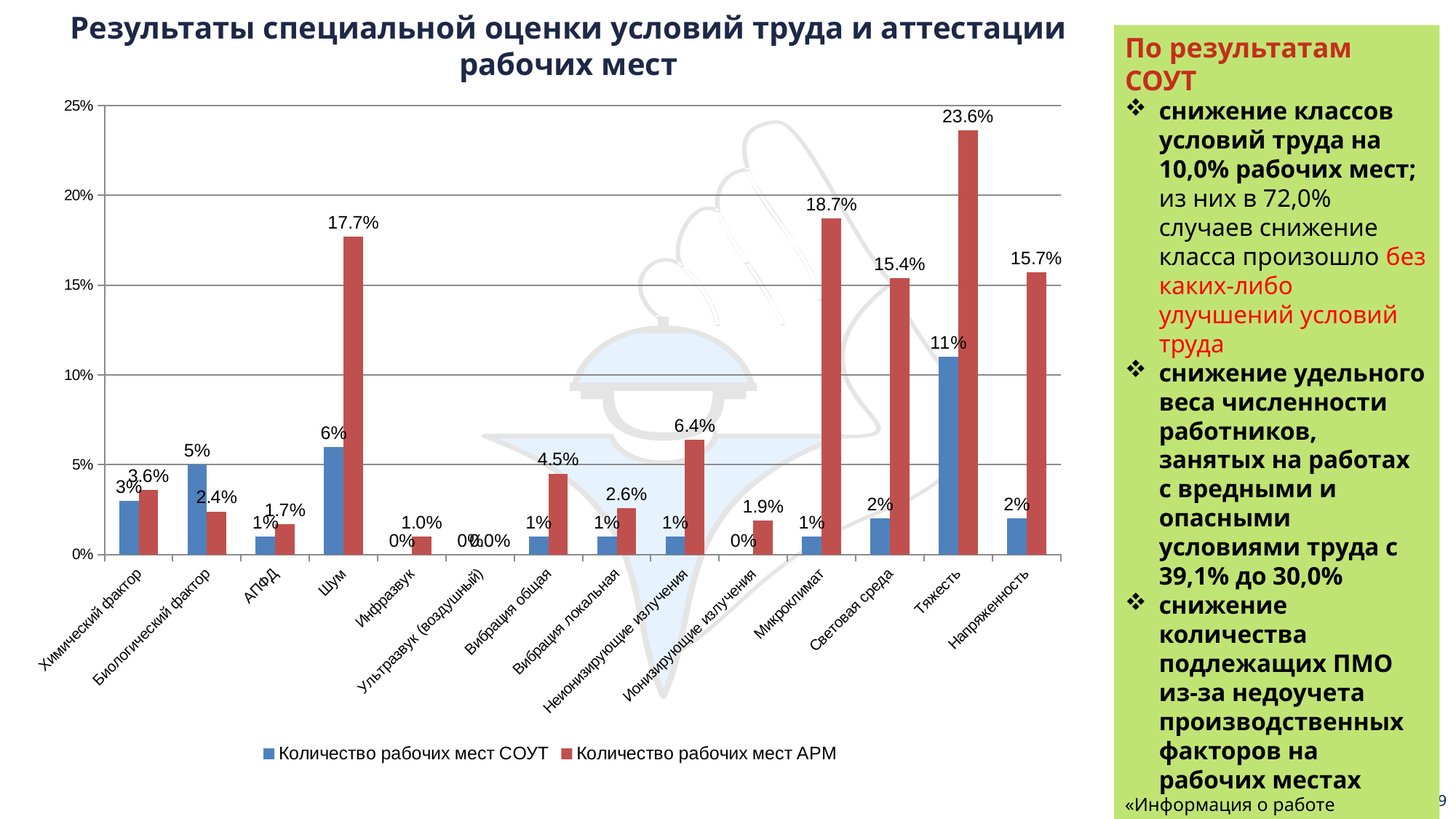
How many series does the legend list? 2 How many categories are shown on the x axis? 14 What kind of chart is shown on the slide? Bar chart What is the value of Количество рабочих мест АРМ for Микроклимат? 18.7% What is the value of Количество рабочих мест СОУТ for Тяжесть? 11% Is the value of Количество рабочих мест АРМ for Световая среда greater or less than 10%? greater What is the value of Количество рабочих мест АРМ for Шум? 17.7% What colour are the bars for Количество рабочих мест АРМ? Red Which category has the highest value for Количество рабочих мест АРМ? Тяжесть What is the difference between Количество рабочих мест АРМ and Количество рабочих мест СОУТ for Тяжесть? 12.6% Which category has the highest value for Количество рабочих мест СОУТ? Тяжесть Which is larger for Биологический фактор: Количество рабочих мест СОУТ or Количество рабочих мест АРМ? Количество рабочих мест СОУТ